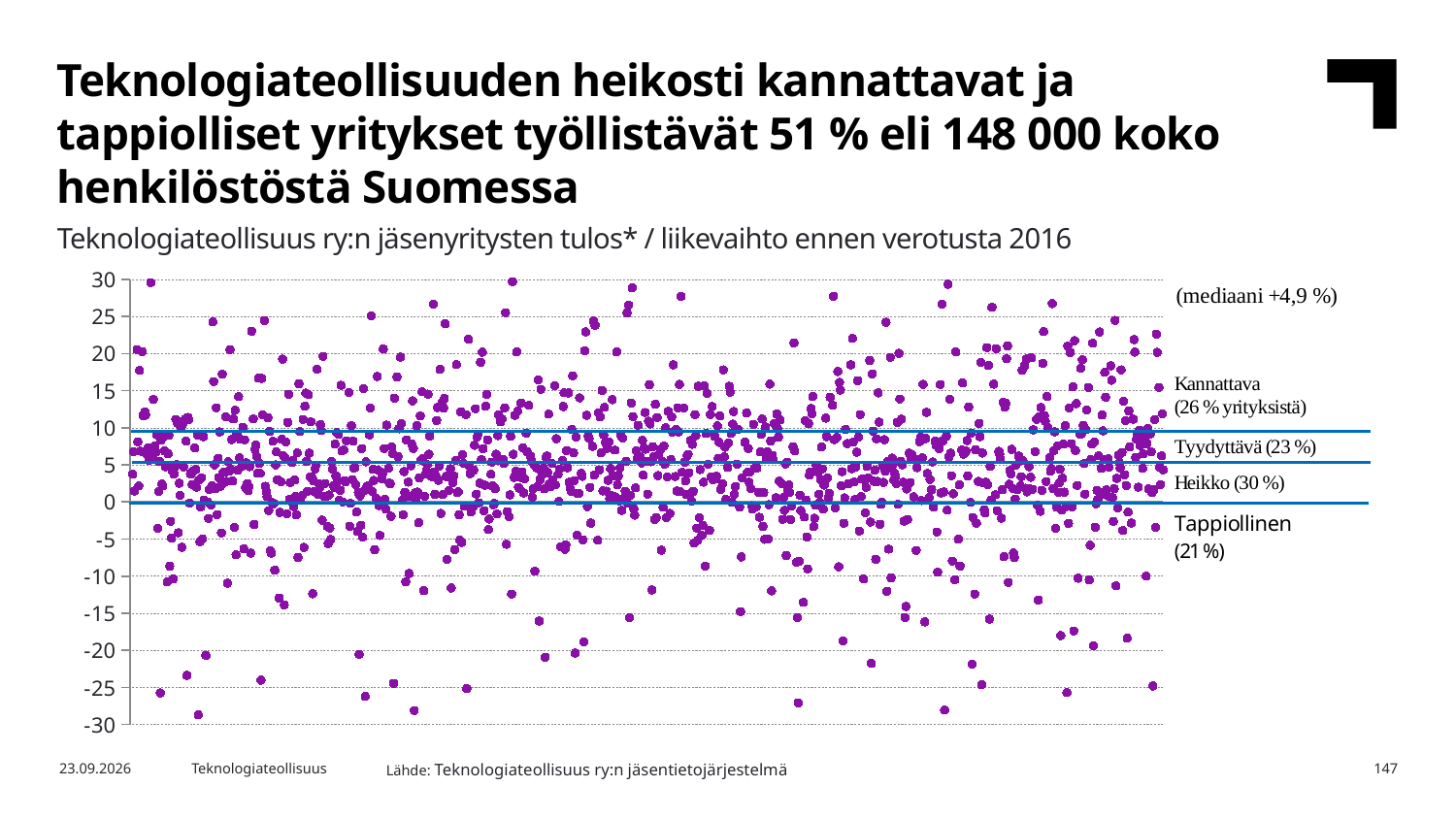
What median value is stated on the chart? +4,9 % What is the highest value shown on the vertical axis? 30 What share of companies is labelled as Kannattava on the chart? 26 % Which share is larger, Heikko or Tyydyttävä? Heikko What share of companies is labelled as Heikko on the chart? 30 % What kind of chart is shown on the slide? Scatter chart Which of the four profitability categories has the largest share of companies? Heikko Which of the four profitability categories has the smallest share of companies? Tappiollinen How many percentage points larger is the Kannattava share than the Tappiollinen share? 5 What share of companies is labelled as Tyydyttävä on the chart? 23 % What share of companies is labelled as Tappiollinen on the chart? 21 % What year does the chart subtitle refer to? 2016